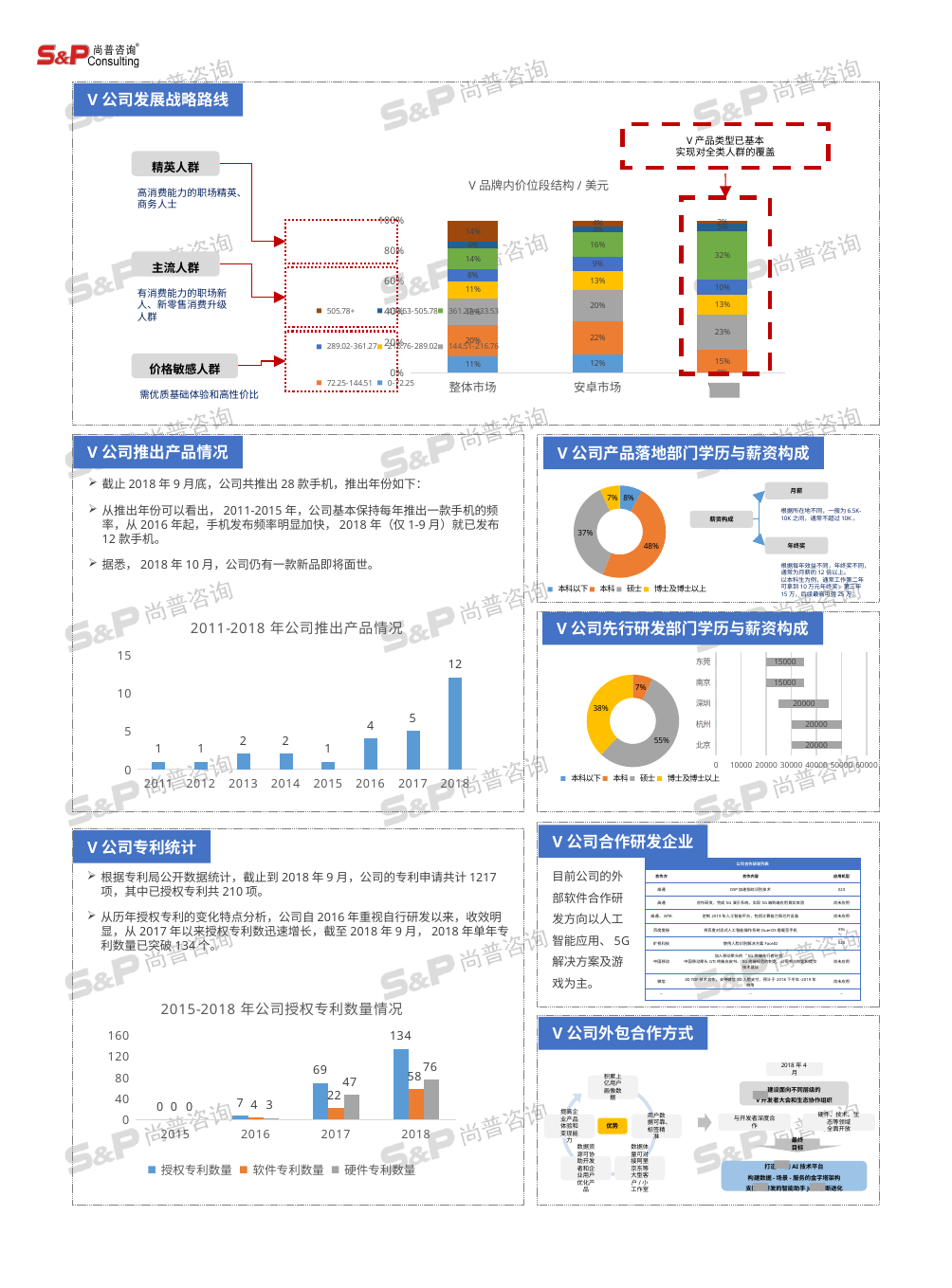
What kind of chart is the one titled 2011-2018 年公司推出产品情况? Bar chart In the chart titled 2015-2018 年公司授权专利数量情况, what is the value of 授权专利数量 for 2018? 134 In the chart titled 2011-2018 年公司推出产品情况, how many products were launched in 2018? 12 In the chart titled 2011-2018 年公司推出产品情况, which year has the highest value? 2018 In the doughnut chart under V 公司产品落地部门学历与薪资构成, what share does 本科 have? 48% In the chart titled 2015-2018 年公司授权专利数量情况, what is the value of 软件专利数量 for 2017? 22 In the chart titled 2011-2018 年公司推出产品情况, what is the difference between the 2018 value and the 2017 value? 7 In the chart titled 2011-2018 年公司推出产品情况, how many years are shown on the x axis? 8 In the chart titled 2015-2018 年公司授权专利数量情况, how many series does the legend list? 3 In the doughnut chart under V 公司先行研发部门学历与薪资构成, what share does 硕士 have? 55% In the chart titled 2015-2018 年公司授权专利数量情况, what is the difference between 硬件专利数量 and 软件专利数量 in 2017? 25 In the chart titled 2015-2018 年公司授权专利数量情况, which is larger for 2018: 软件专利数量 or 硬件专利数量? 硬件专利数量